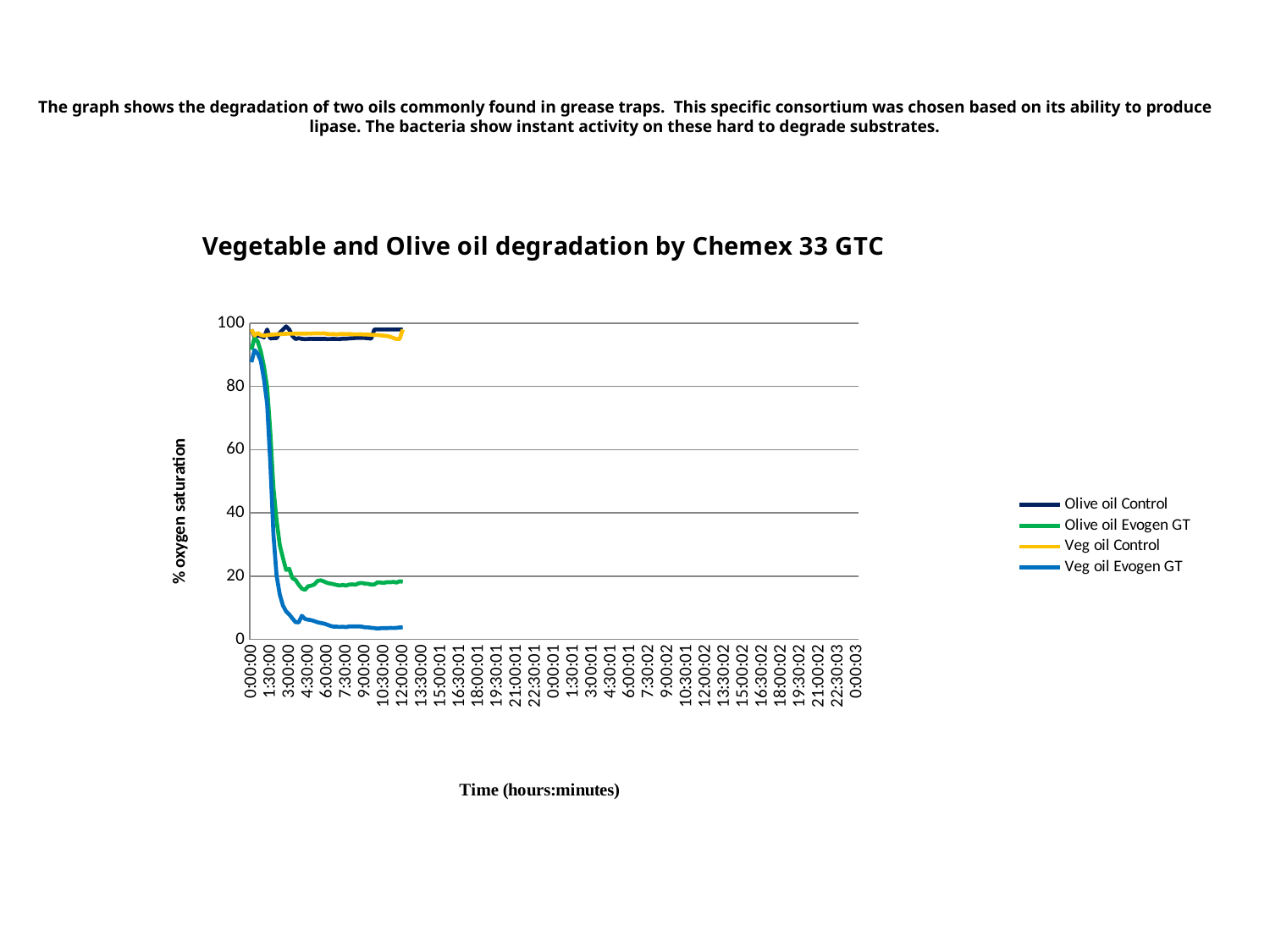
Does the Veg oil Evogen GT series rise or fall over time? fall Does the Olive oil Evogen GT series rise or fall over time? fall What is the title of the chart? Vegetable and Olive oil degradation by Chemex 33 GTC Which series has the lowest value at 12:00:00? Veg oil Evogen GT At 12:00:00, which is higher: Olive oil Evogen GT or Veg oil Evogen GT? Olive oil Evogen GT Is the value for Olive oil Evogen GT at 12:00:00 greater or less than 40? less Is the value for Veg oil Evogen GT at 12:00:00 greater or less than 20? less At 0:00:00, which is higher: Veg oil Control or Veg oil Evogen GT? Veg oil Control Is the value for Olive oil Control at 12:00:00 greater or less than 80? greater How many series does the legend list? 4 What kind of chart is shown on the slide? line chart What is the label on the y axis of the chart? % oxygen saturation